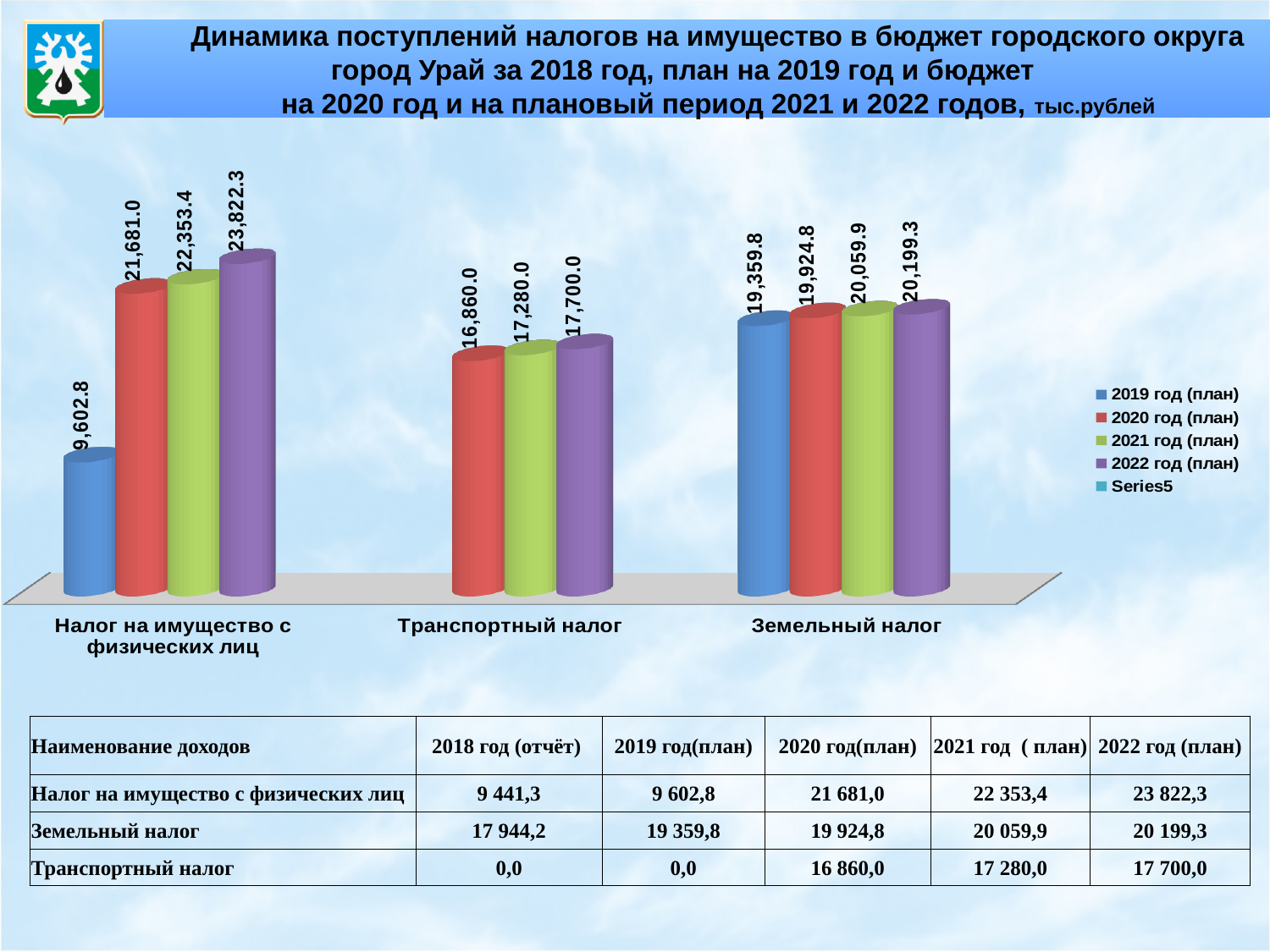
What is the difference between the 2022 год (план) and 2020 год (план) values for Транспортный налог? 840.0 Do the values for Земельный налог rise or fall from 2019 год (план) to 2022 год (план)? Rise What is the difference between the 2022 год (план) and 2019 год (план) values for Налог на имущество с физических лиц? 14,219.5 What is the value of the 2022 год (план) bar for Налог на имущество с физических лиц? 23,822.3 Which category has the lowest 2019 год (план) bar? Налог на имущество с физических лиц What is the value of the 2020 год (план) bar for Транспортный налог? 16,860.0 Which category has the highest 2022 год (план) bar? Налог на имущество с физических лиц How many series does the chart legend list? 5 How many categories are shown on the x axis of the chart? 3 What is the value of the 2019 год (план) bar for Земельный налог? 19,359.8 Which is larger: the 2021 год (план) value for Земельный налог or the 2021 год (план) value for Транспортный налог? Земельный налог What kind of chart is shown on the slide? Bar chart